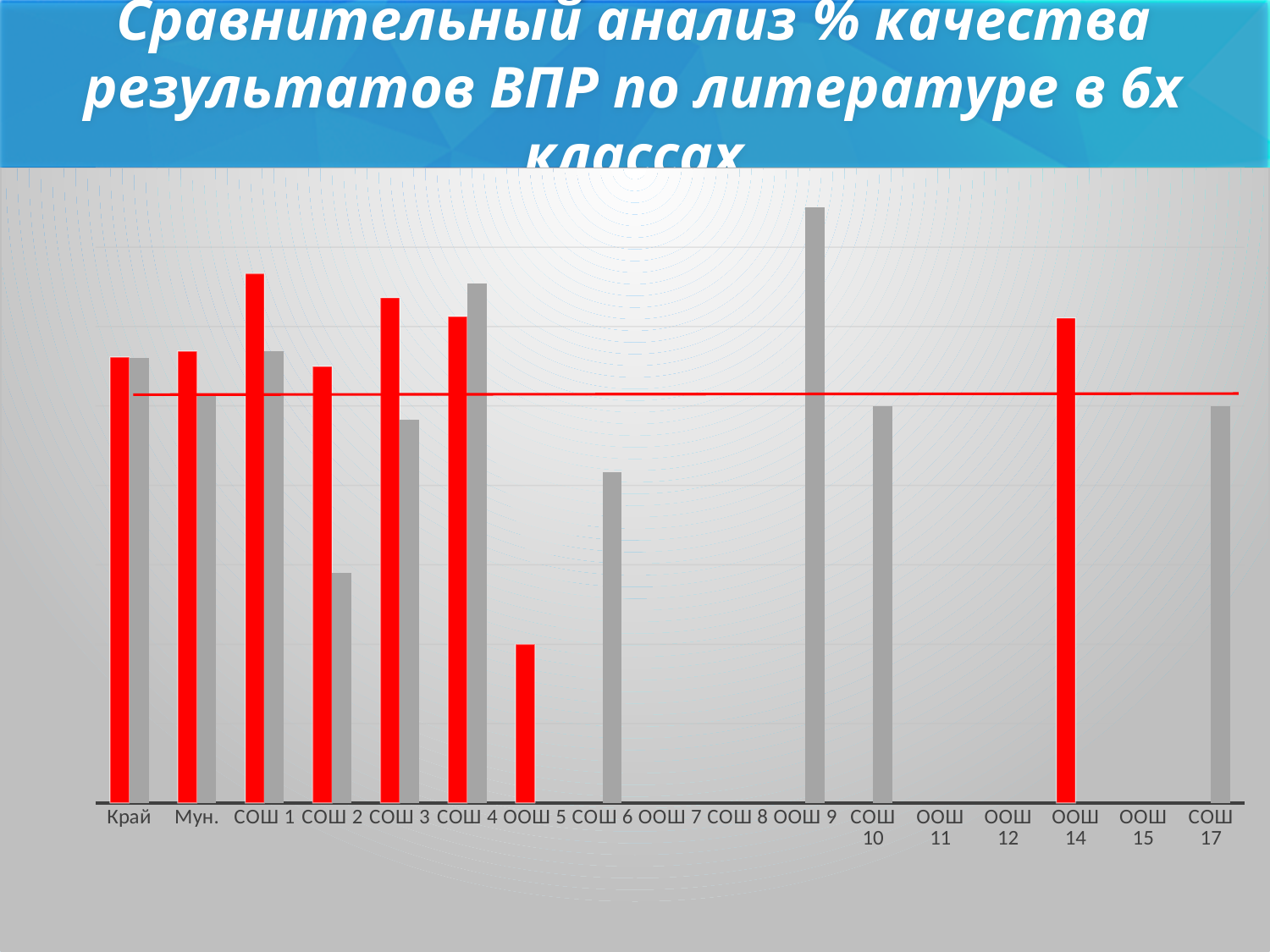
Is the red bar for СОШ 1 taller or shorter than the red bar for ООШ 5? taller What is the first category on the x axis of the chart? Край Is the grey bar for ООШ 9 taller or shorter than the grey bar for СОШ 6? taller Which category has the tallest red bar in the chart? СОШ 1 How many categories are labelled on the x axis of the chart? 17 Which category has the tallest bar in the chart? ООШ 9 What two colours are used for the bars in the chart? red and grey What kind of chart is shown on the slide? bar chart Which category has the shortest red bar in the chart? ООШ 5 Is the grey bar for СОШ 4 taller or shorter than the red bar for СОШ 4? taller